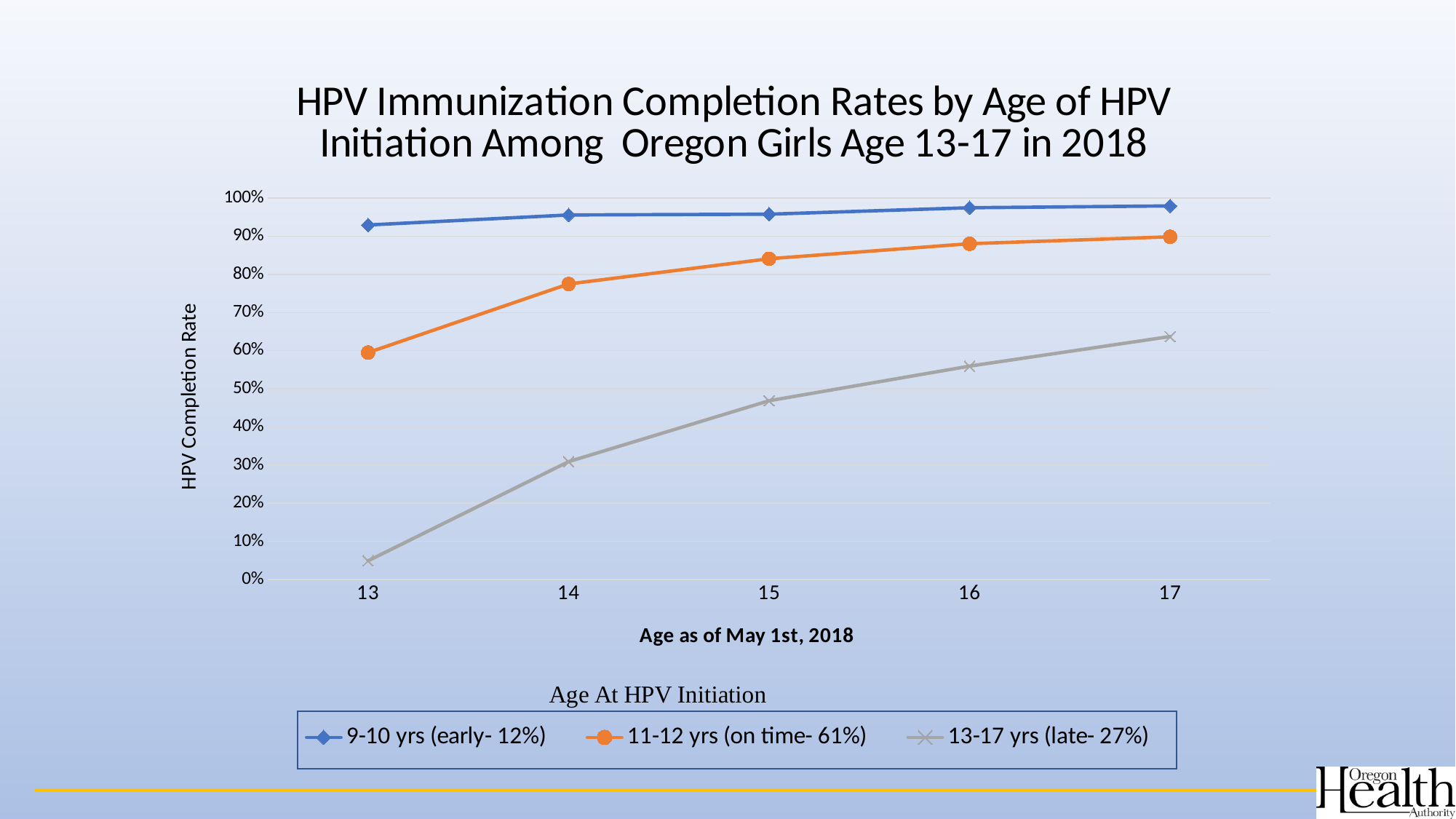
Is the value for the 9-10 yrs (early- 12%) series at age 13 greater or less than 90%? greater Is the value for the 13-17 yrs (late- 27%) series at age 17 greater or less than 60%? greater Which series has the highest HPV completion rate at age 17? 9-10 yrs (early- 12%) Is the value for the 11-12 yrs (on time- 61%) series at age 13 greater or less than 70%? less How many age categories are shown along the x axis? 5 What is the label of the y axis? HPV Completion Rate How many series does the legend list? 3 What kind of chart is shown on the slide? line chart Does the HPV completion rate for the 13-17 yrs (late- 27%) series rise or fall from age 13 to age 17? rise Which series has the lowest HPV completion rate at age 13? 13-17 yrs (late- 27%)